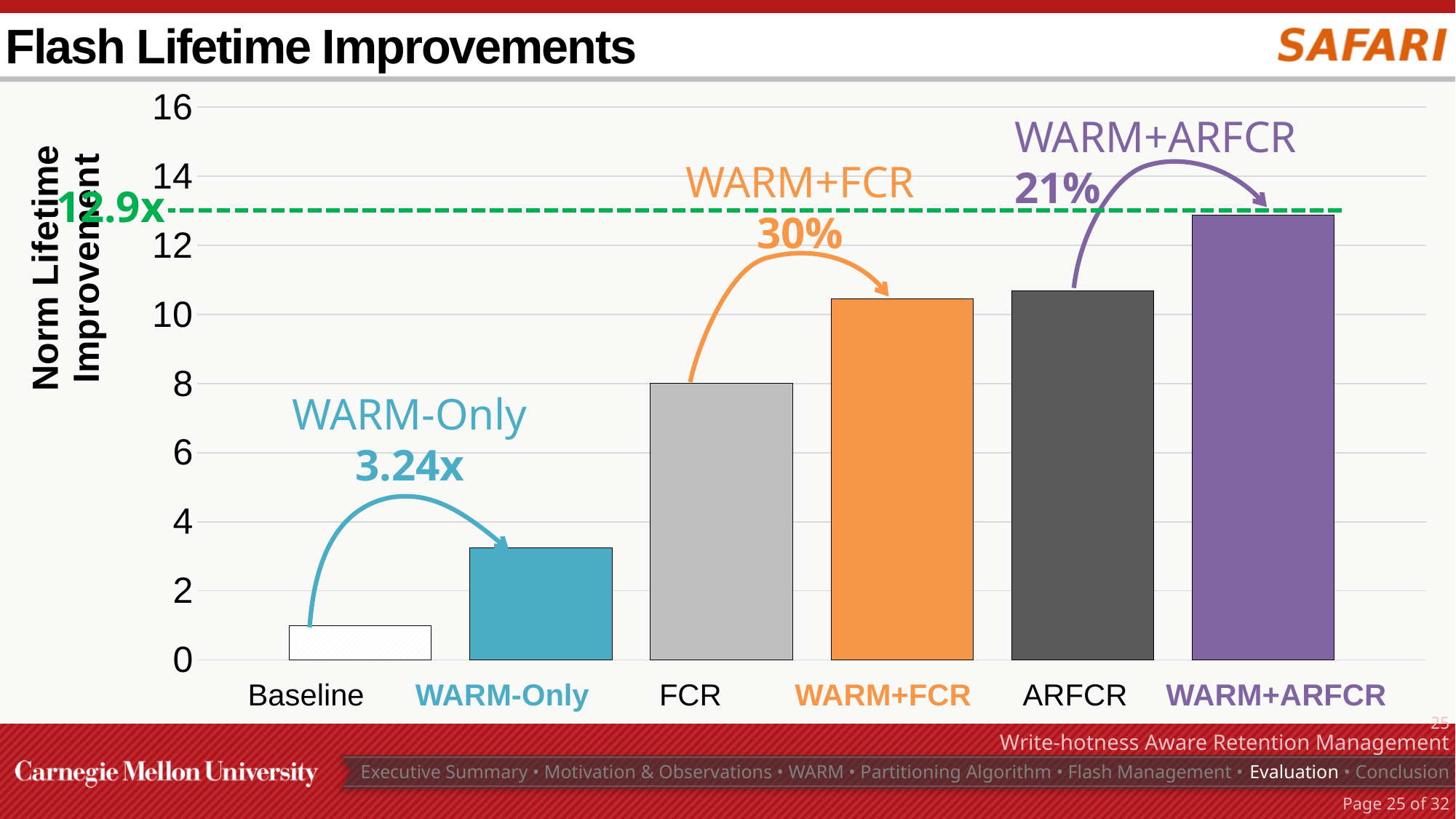
Is the value for FCR greater or less than 6? greater Which category has the highest normalized lifetime improvement? WARM+ARFCR What improvement factor is annotated above the WARM-Only bar? 3.24x Which is larger, the value for FCR or the value for WARM-Only? FCR What percentage improvement is annotated for WARM+FCR over FCR? 30% Is the value for Baseline greater or less than 2? less What kind of chart is shown on the slide? bar chart Is the value for WARM+ARFCR greater or less than 12? greater How many categories are plotted along the x axis? 6 What value is marked by the green dashed line at the top of the WARM+ARFCR bar? 12.9x Which category has the lowest normalized lifetime improvement? Baseline